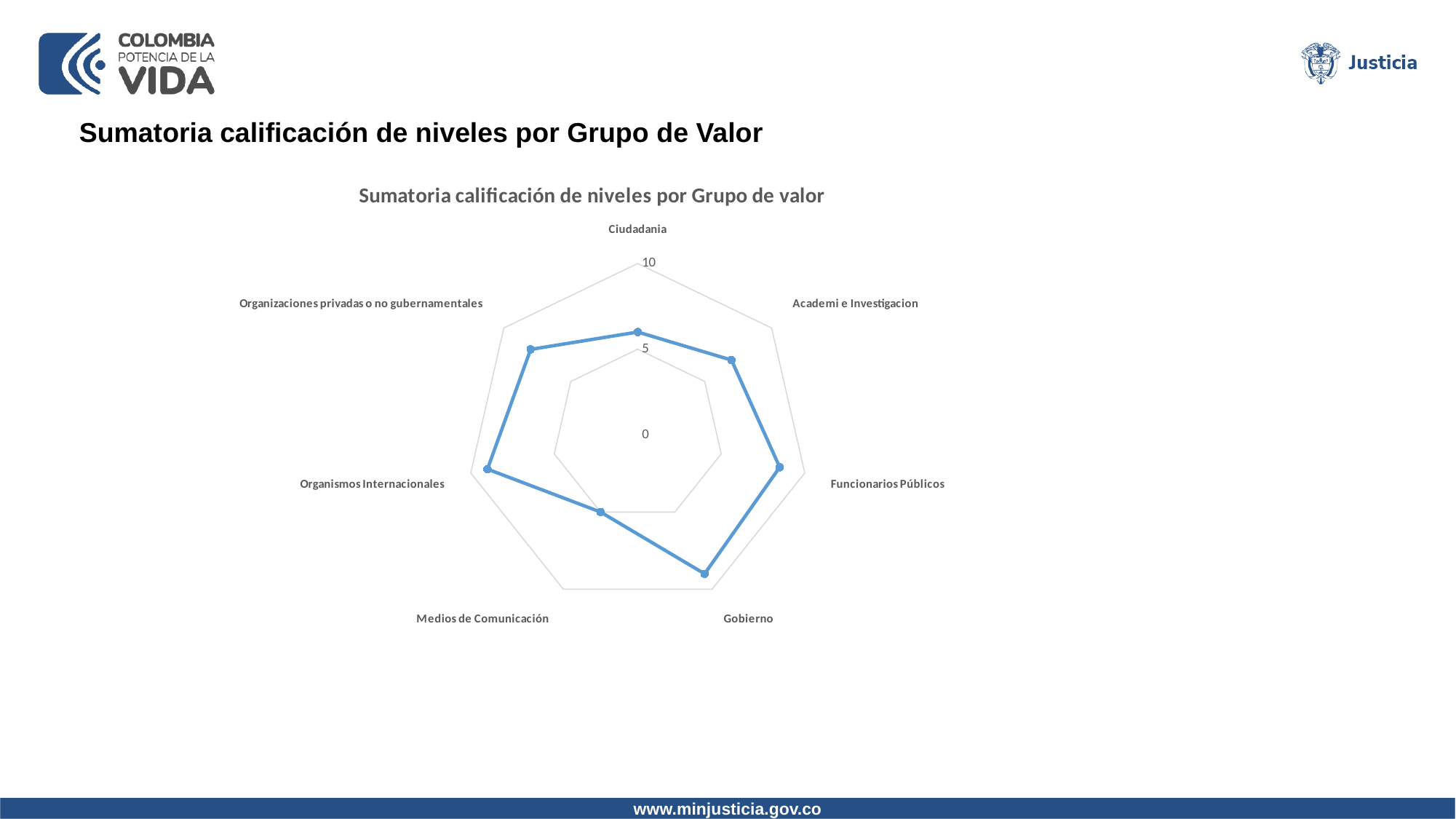
Is the value for Funcionarios Públicos greater or less than 5? greater Which has the larger value, Funcionarios Públicos or Ciudadania? Funcionarios Públicos Which has the larger value, Gobierno or Medios de Comunicación? Gobierno What is the maximum value shown on the chart's axis scale? 10 Which has the larger value, Organismos Internacionales or Ciudadania? Organismos Internacionales Is the value for Organismos Internacionales greater or less than 5? greater Is the value for Gobierno greater or less than 5? greater What kind of chart is shown on the slide? Radar chart What is the title of the chart? Sumatoria calificación de niveles por Grupo de valor How many categories (grupos de valor) are plotted on the radar chart? 7